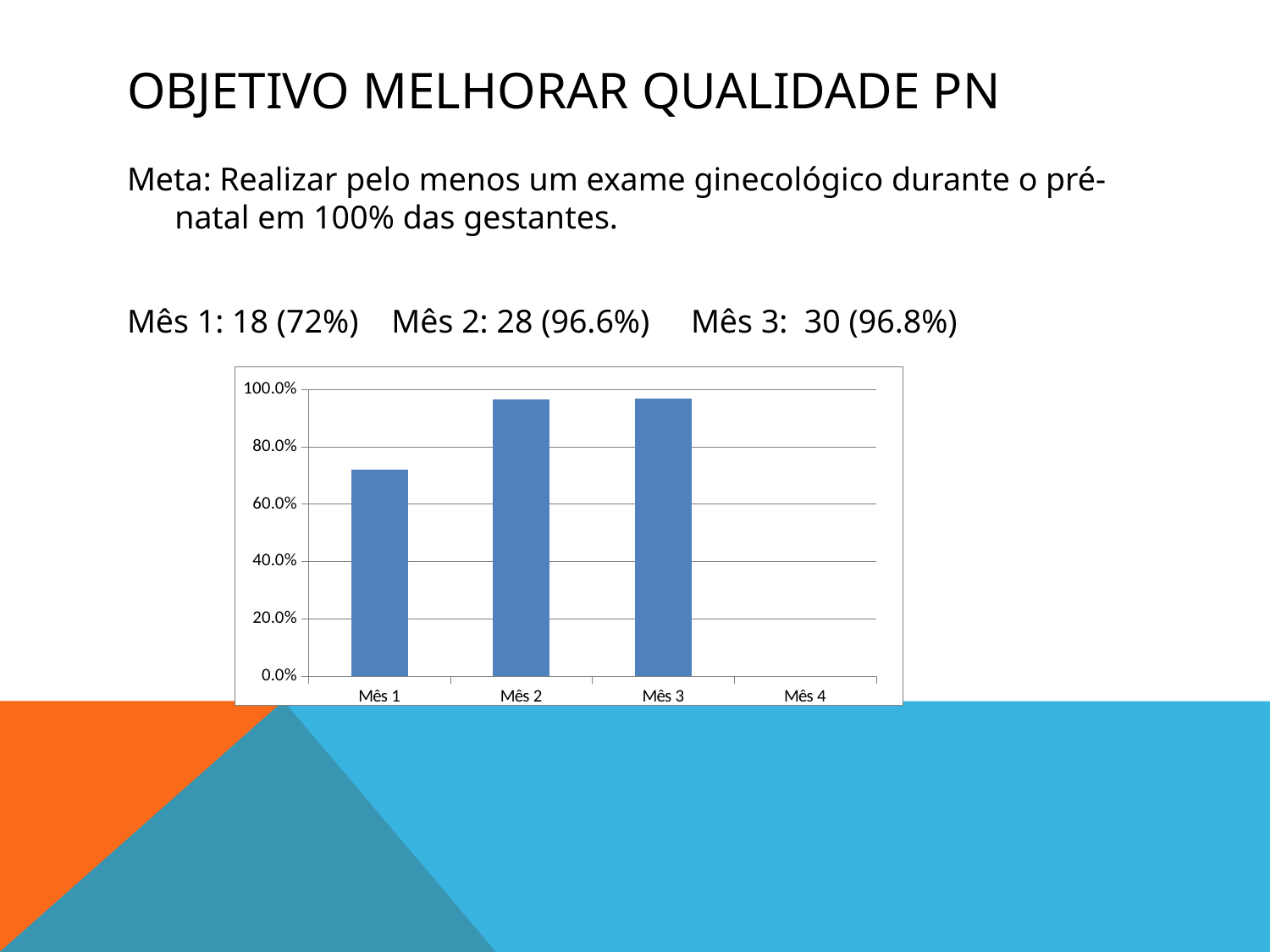
What is the highest tick label shown on the y axis of the chart? 100.0% According to the slide, what is the percentage value for Mês 1? 72% According to the slide, what is the percentage value for Mês 3? 96.8% What kind of chart is shown on the slide? bar chart According to the slide, what is the percentage value for Mês 2? 96.6% What is the difference in percentage points between Mês 2 (96.6%) and Mês 1 (72%)? 24.6 Is the value for Mês 2 greater or less than 80.0%? greater How many of the months on the x axis have a bar plotted? 3 Do the bar values rise or fall from Mês 1 to Mês 3? rise Is the value for Mês 1 greater or less than 80.0%? less How many categories are shown on the x axis of the chart? 4 Which is larger, the value for Mês 1 or the value for Mês 2? Mês 2